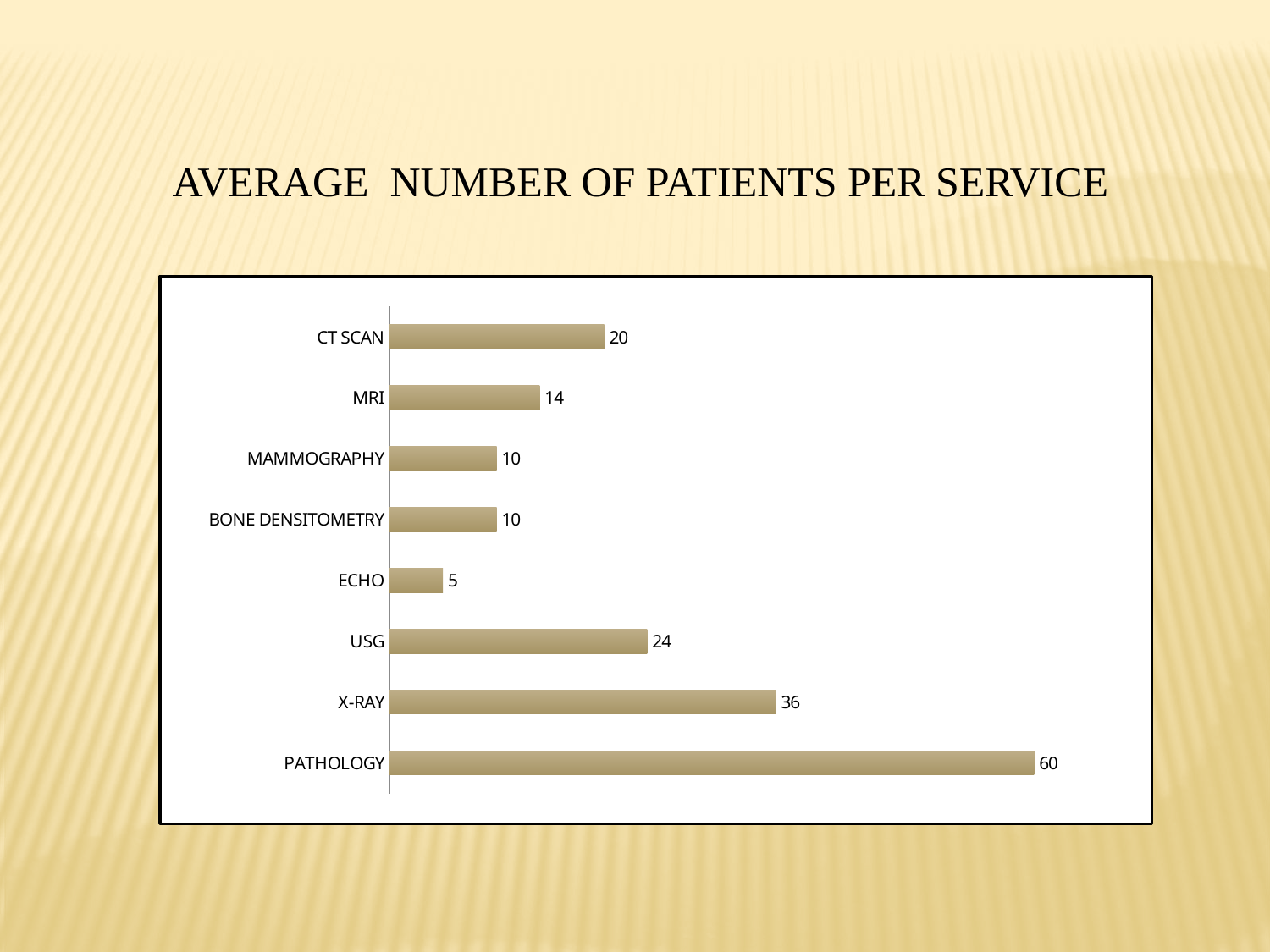
What is the difference between the values for PATHOLOGY and X-RAY? 24 Which has a larger value, USG or CT SCAN? USG What is the title of the slide? AVERAGE NUMBER OF PATIENTS PER SERVICE Which service has the highest average number of patients? PATHOLOGY What kind of chart is shown on the slide? Bar chart Which has a larger value, MRI or MAMMOGRAPHY? MRI How many services are shown in the chart? 8 What is the average number of patients for MRI? 14 What is the difference between the values for CT SCAN and ECHO? 15 Which service has the lowest average number of patients? ECHO What is the average number of patients for USG? 24 What is the average number of patients for PATHOLOGY? 60